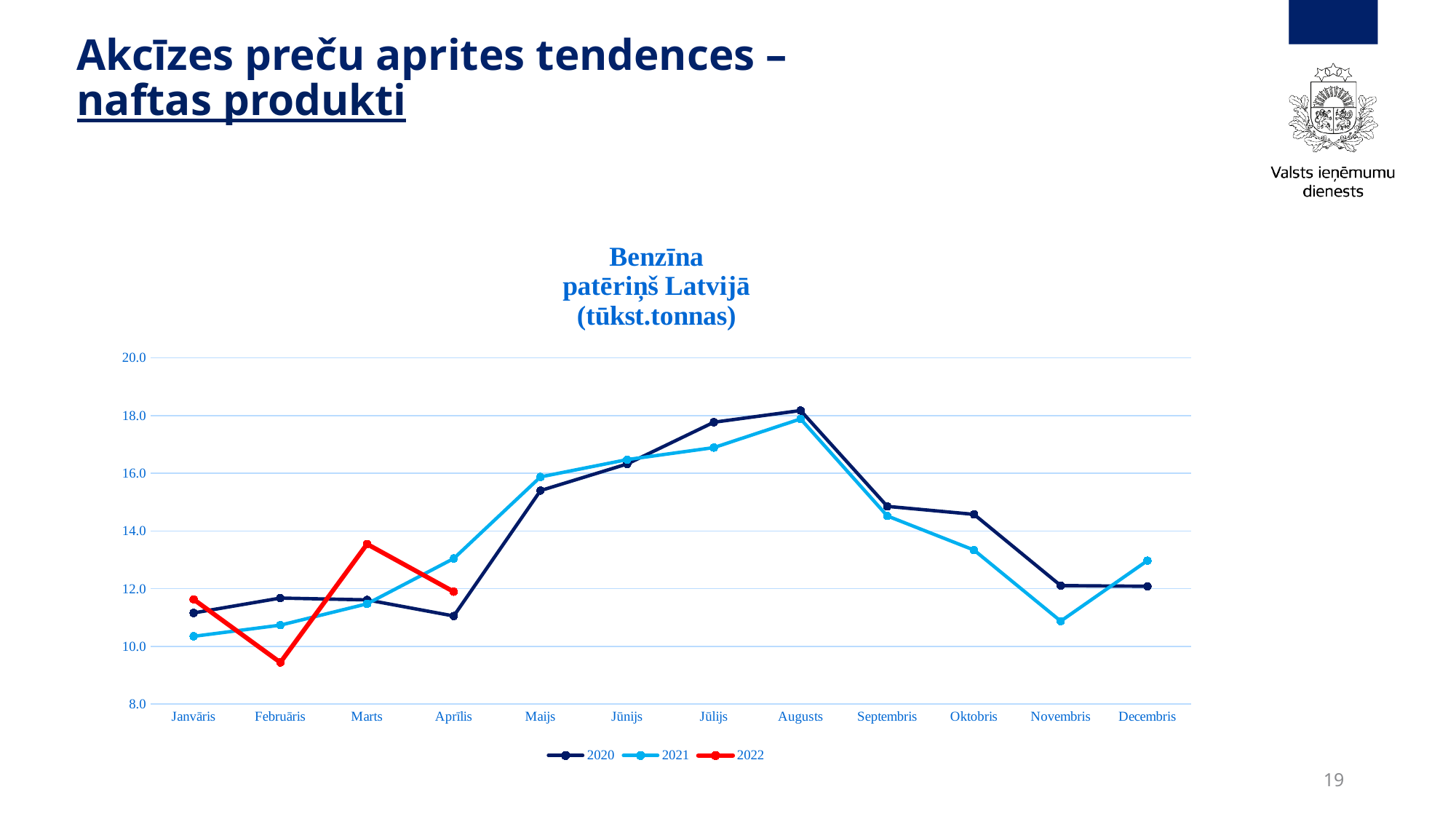
In which month does the 2022 series have its highest value? Marts How many data points does the 2022 series have? 4 How many months are shown along the x axis? 12 Is the value for 2022 in Februāris greater or less than 10.0? less In which month does the 2022 series have its lowest value? Februāris In which month does the 2020 series reach its highest value? Augusts How many series does the legend list? 3 Is the value for 2020 in Augusts greater or less than 18.0? greater In Marts, which series has the larger value, 2020 or 2022? 2022 What kind of chart is shown on the slide? line chart Does the 2022 series rise or fall from Marts to Aprīlis? fall What colour is the line for the 2022 series? red